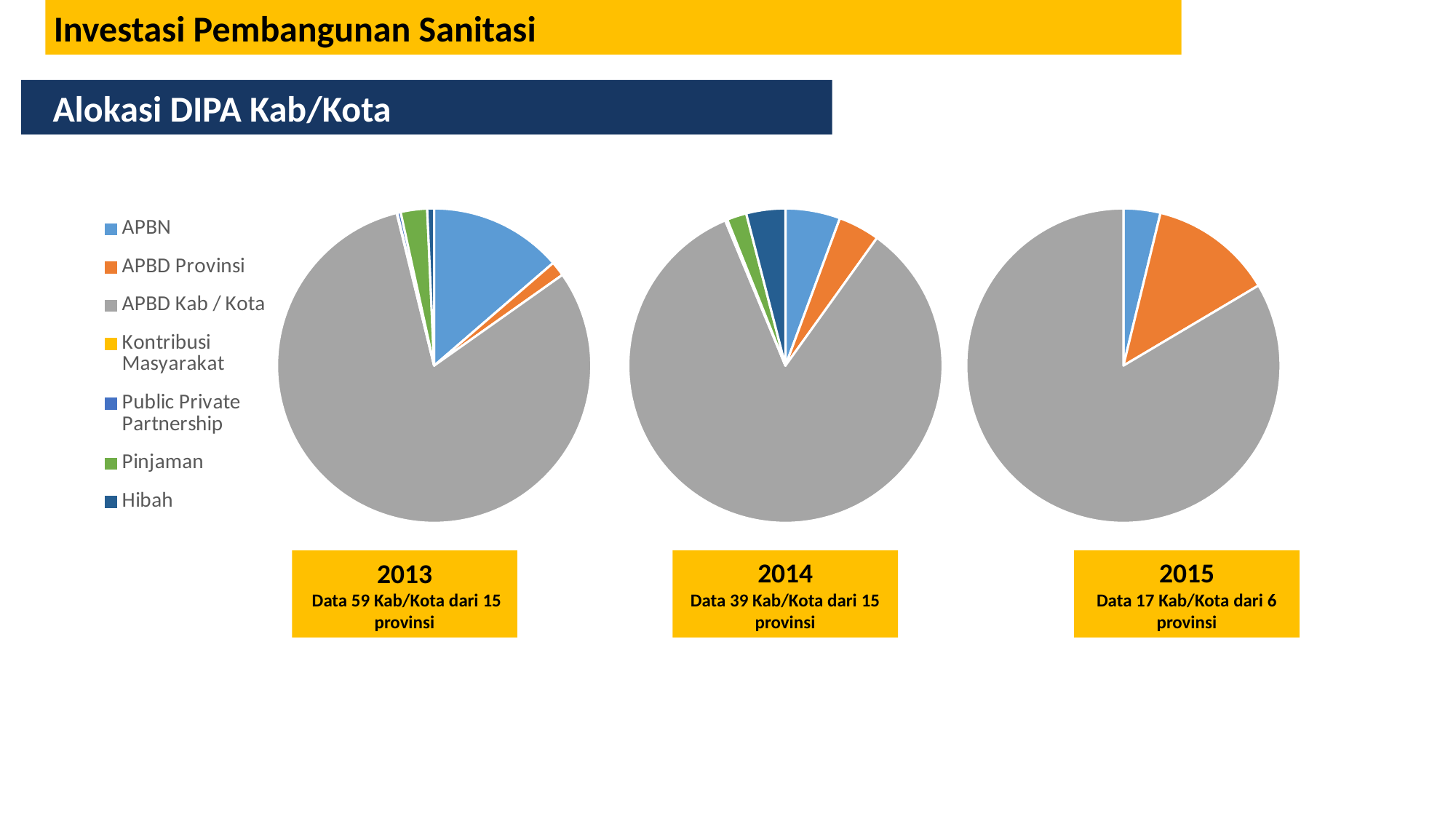
In the 2013 pie chart, which category has the largest slice? APBD Kab / Kota In the 2014 pie chart, which category has the largest slice? APBD Kab / Kota Which colour represents APBD Kab / Kota in the legend? Grey In the 2013 pie chart, which slice is larger, APBN or APBD Provinsi? APBN In the 2015 pie chart, which category has the largest slice? APBD Kab / Kota In the 2015 pie chart, which slice is larger, APBN or APBD Provinsi? APBD Provinsi In the 2013 pie chart, which slice is larger, Pinjaman or Hibah? Pinjaman Which year's pie chart is based on data from 17 Kab/Kota in 6 provinces? 2015 What kind of charts are shown on the slide? Pie charts How many pie charts are on the slide? 3 How many entries does the legend list? 7